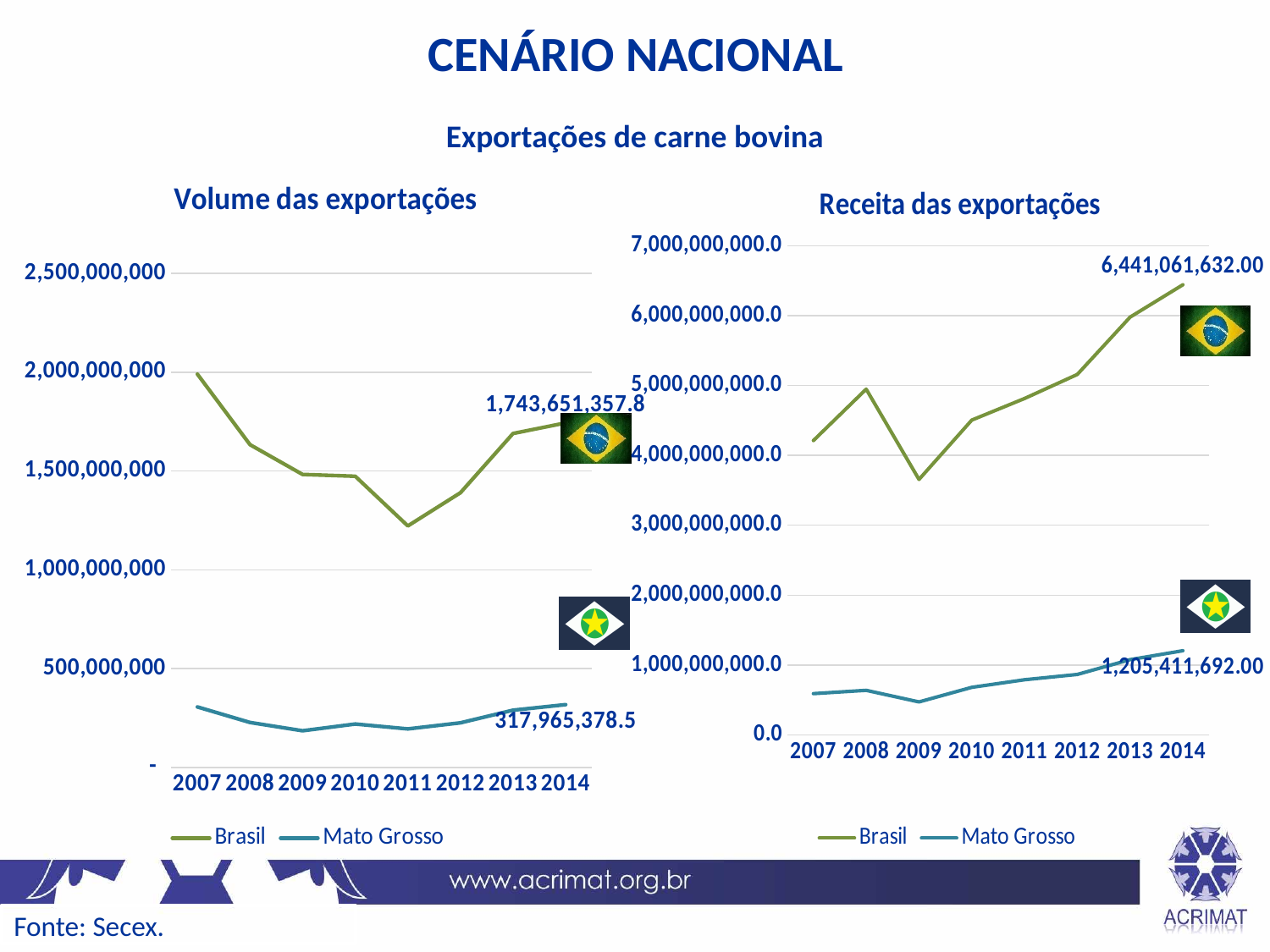
In the 'Volume das exportações' chart, in which year is the Brasil line at its lowest? 2011 What kind of chart is the 'Volume das exportações' chart? Line chart In the 'Volume das exportações' chart, what is the labelled value for Mato Grosso in 2014? 317,965,378.5 How many years are shown on the x axis of the 'Volume das exportações' chart? 8 How many series does the legend of the 'Receita das exportações' chart list? 2 In the 'Receita das exportações' chart, in which year is the Brasil line at its lowest? 2009 In the 'Volume das exportações' chart, what is the labelled value for Brasil in 2014? 1,743,651,357.8 In the 'Receita das exportações' chart, in which year is the Brasil line at its highest? 2014 In the 'Receita das exportações' chart, what is the labelled value for Mato Grosso in 2014? 1,205,411,692.00 In the 'Volume das exportações' chart, is the Brasil value for 2007 greater or less than 1,500,000,000? greater In the 'Receita das exportações' chart, what is the labelled value for Brasil in 2014? 6,441,061,632.00 In the 'Volume das exportações' chart, what is the difference between the 2014 values for Brasil and Mato Grosso? 1,425,685,979.3